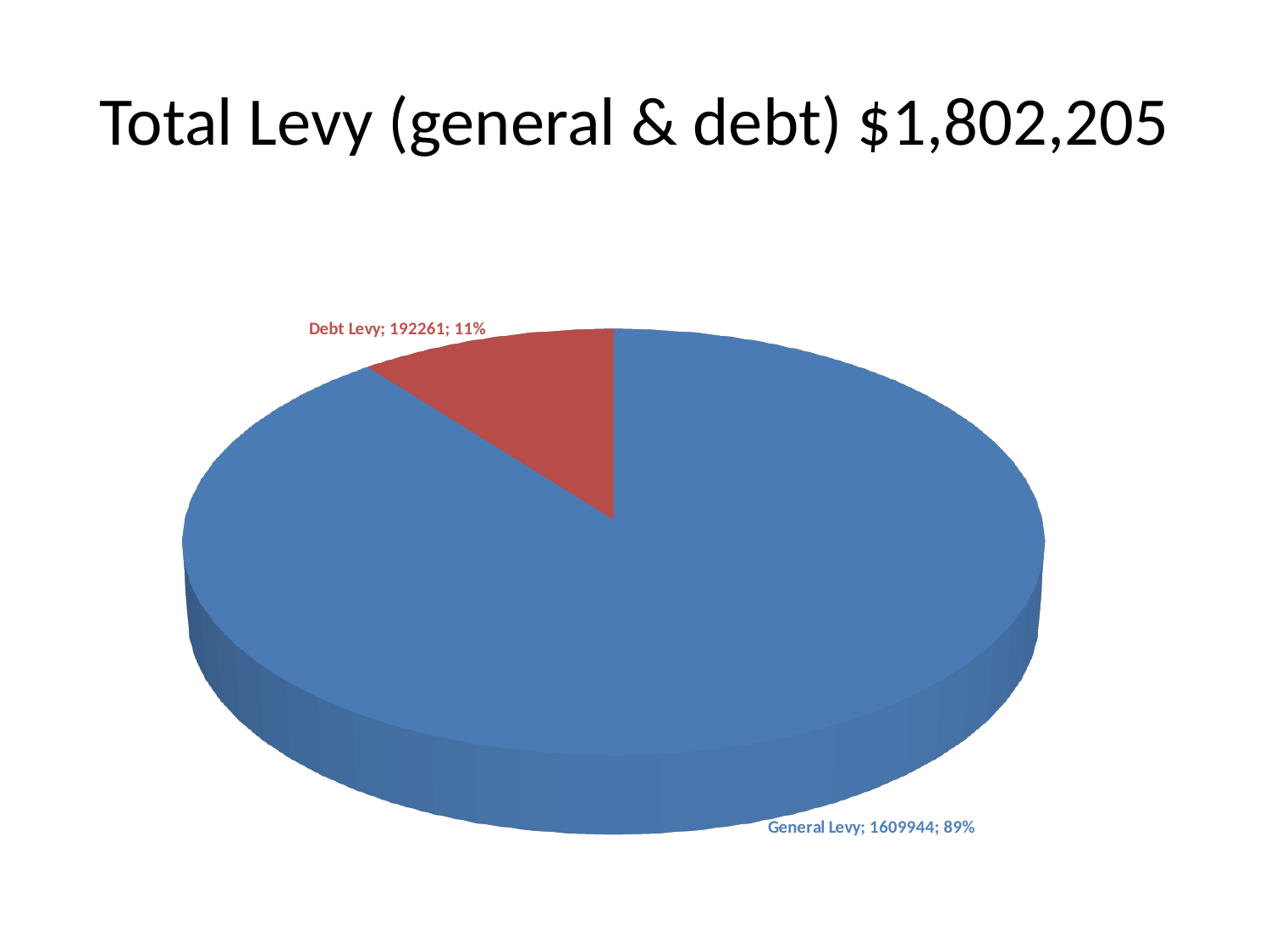
What share of the pie does the Debt Levy slice represent? 11% Which slice is the smallest? Debt Levy What is the value of the Debt Levy slice? 192261 Which is larger, the General Levy or the Debt Levy? General Levy What is the title of the slide? Total Levy (general & debt) $1,802,205 What kind of chart is shown on the slide? Pie chart How many slices does the pie chart have? 2 What colour is the Debt Levy slice? Red Which slice is the largest? General Levy What share of the pie does the General Levy slice represent? 89% What is the value of the General Levy slice? 1609944 What is the difference between the General Levy and Debt Levy values? 1417683